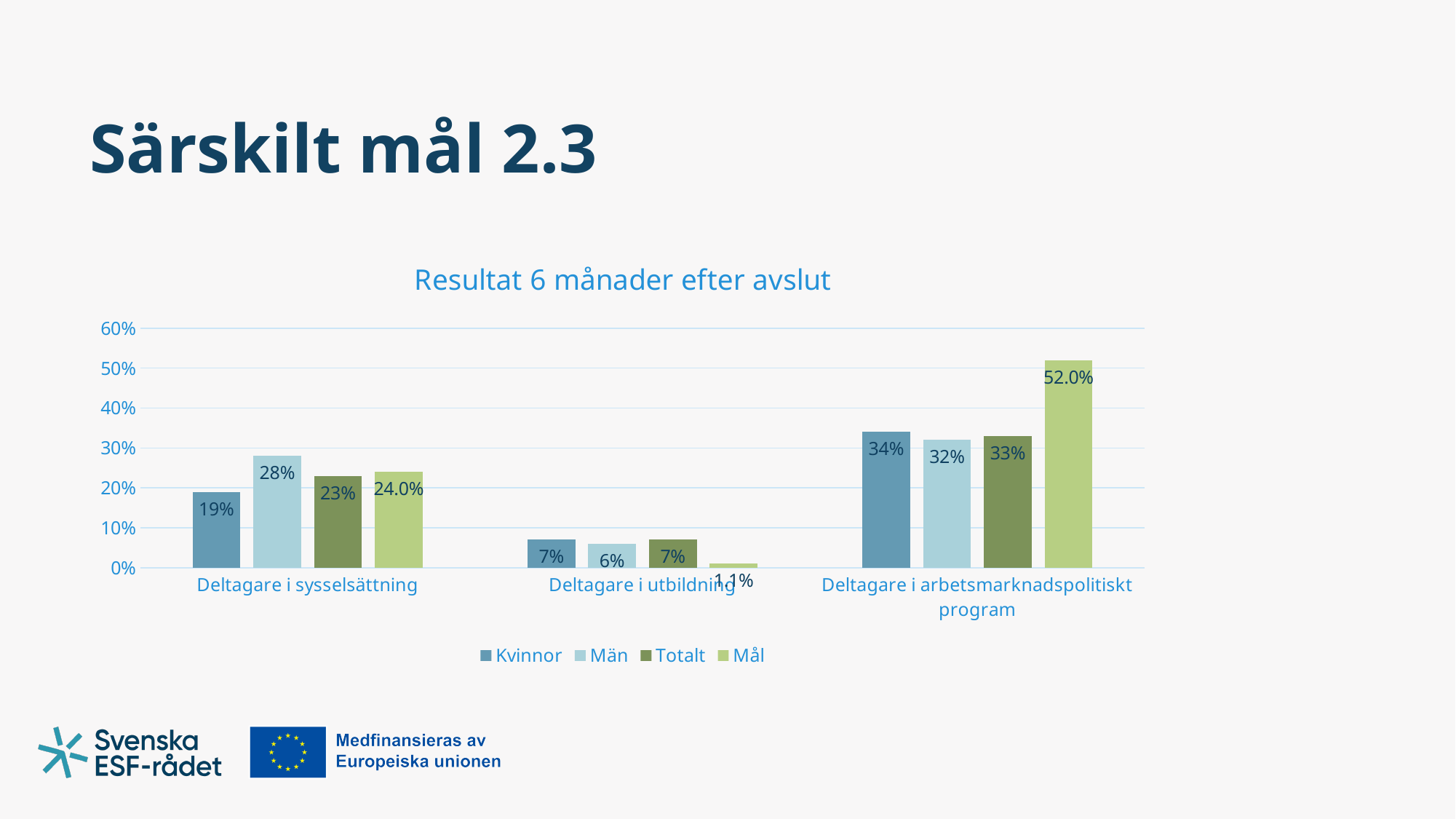
What is the difference between the Män and Kvinnor values for Deltagare i sysselsättning? 9% How many series does the legend list? 4 What is the Mål value for Deltagare i utbildning? 1.1% What is the title of the chart? Resultat 6 månader efter avslut What is the value for Män in the Deltagare i utbildning category? 6% What is the value for Kvinnor in the Deltagare i sysselsättning category? 19% What is the Mål value for Deltagare i arbetsmarknadspolitiskt program? 52.0% Which is larger for Deltagare i arbetsmarknadspolitiskt program, the Kvinnor value or the Män value? Kvinnor Is the Mål value for Deltagare i arbetsmarknadspolitiskt program greater or less than 50%? greater Which category has the lowest Mål value? Deltagare i utbildning Which category has the highest Totalt value? Deltagare i arbetsmarknadspolitiskt program How many categories are shown on the x axis? 3